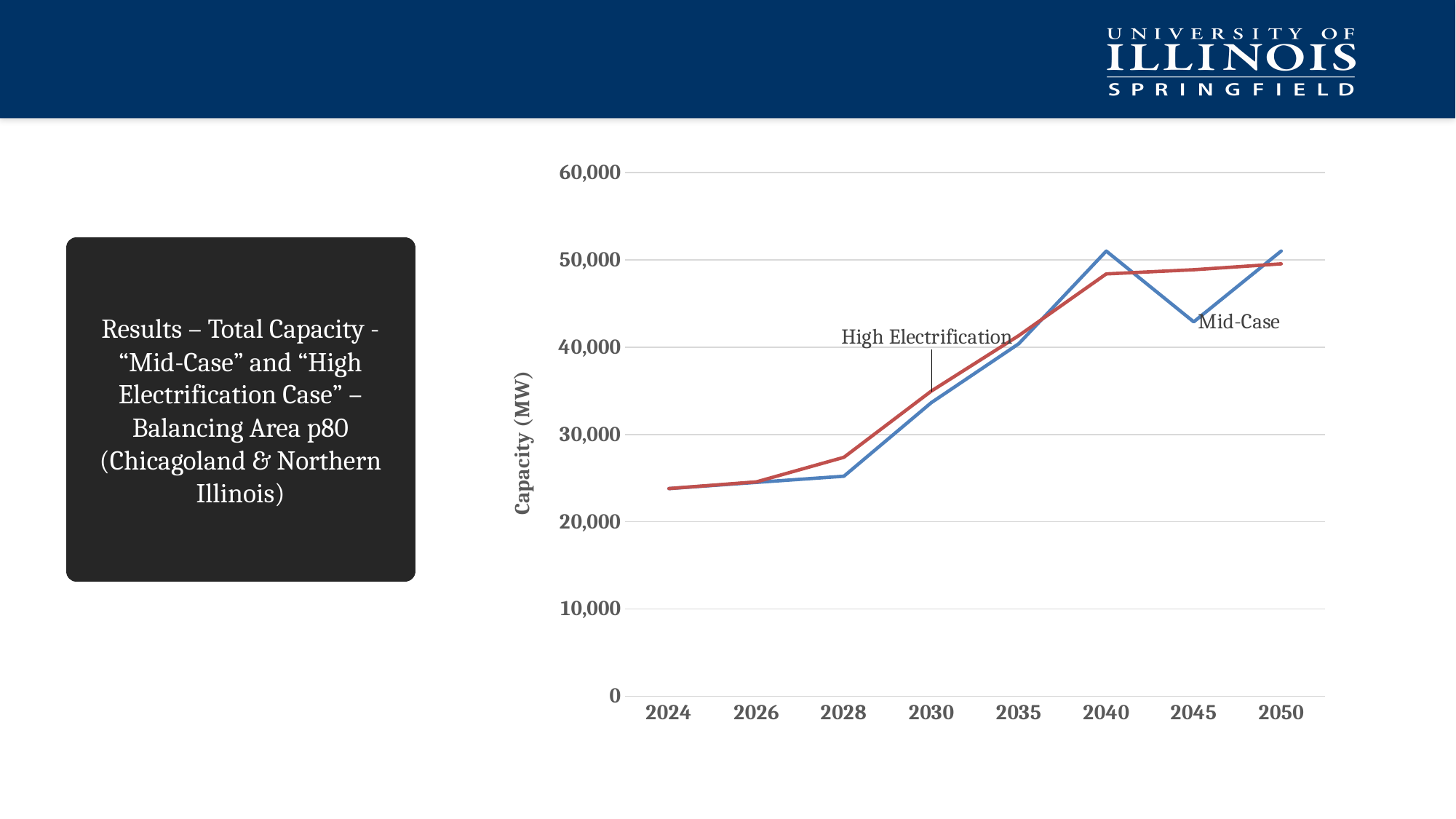
Is the Mid-Case value for 2024 greater or less than 30,000? less Is the High Electrification value for 2028 greater or less than 30,000? less How many years are marked along the x axis of the chart? 8 Is the Mid-Case value for 2045 greater or less than 50,000? less Which year has the lowest Mid-Case capacity? 2024 In 2045, which series has the higher capacity, Mid-Case or High Electrification? High Electrification What is the title of the vertical axis of the chart? Capacity (MW) What kind of chart is shown on the slide? line chart Does the High Electrification line generally rise or fall from 2024 to 2050? rise How many data series are plotted on the chart? 2 In 2028, which series has the higher capacity, Mid-Case or High Electrification? High Electrification